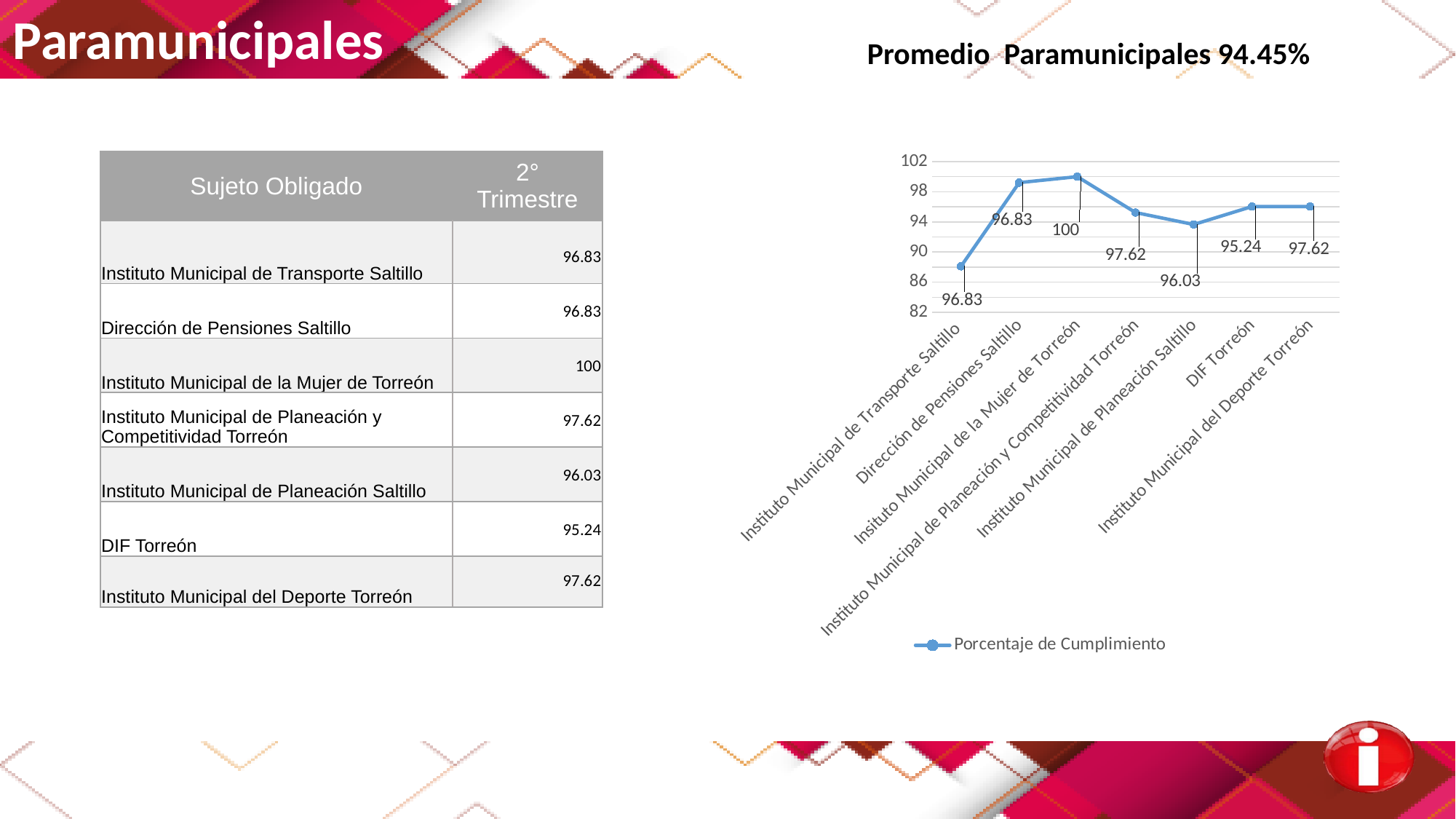
What is the value for Instituto Municipal de Planeación Saltillo? 96.03 What is the value for Dirección de Pensiones Saltillo? 96.83 What is the difference between the values for Instituto Municipal de la Mujer de Torreón and DIF Torreón? 4.76 How many series does the legend list? 1 What is the name of the series shown in the legend? Porcentaje de Cumplimiento What is the value for DIF Torreón? 95.24 Which is larger, the value for Instituto Municipal de Planeación y Competitividad Torreón or the value for Instituto Municipal de Planeación Saltillo? Instituto Municipal de Planeación y Competitividad Torreón What kind of chart is shown on the slide? line chart What is the value for Instituto Municipal de la Mujer de Torreón? 100 Which category has the highest value? Instituto Municipal de la Mujer de Torreón What is the value for Instituto Municipal del Deporte Torreón? 97.62 How many categories are plotted on the x axis? 7